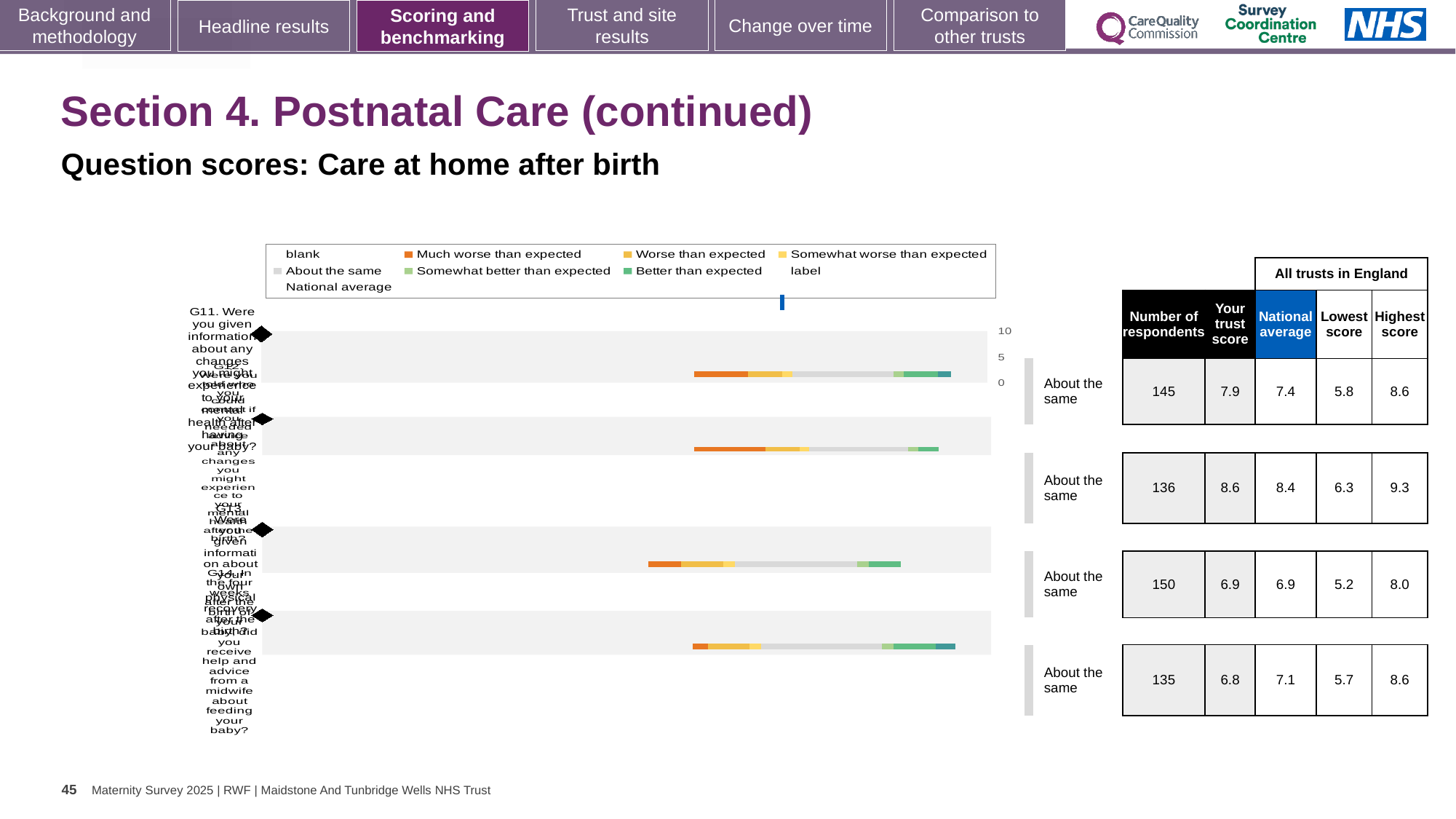
In the table beside the chart, which row has the highest 'Highest score' value? second row (9.3) In the table beside the chart, what is the 'Your trust score' value in the second row? 8.6 In the table beside the chart, what is the number of respondents in the first row? 145 How many horizontal bars does the chart contain? 4 What is the highest tick value shown on the chart's axis? 10 What kind of chart is shown on the slide? bar chart In the table beside the chart, which row has the lowest number of respondents? fourth row (135) In the table beside the chart, which is larger in the first row: the trust score or the national average? trust score In the table beside the chart, what is the difference between the trust score and the national average in the first row? 0.5 In the table beside the chart, what is the lowest score in the third row? 5.2 In the table beside the chart, what is the national average in the fourth row? 7.1 Which colour does the legend use for 'Much worse than expected'? orange